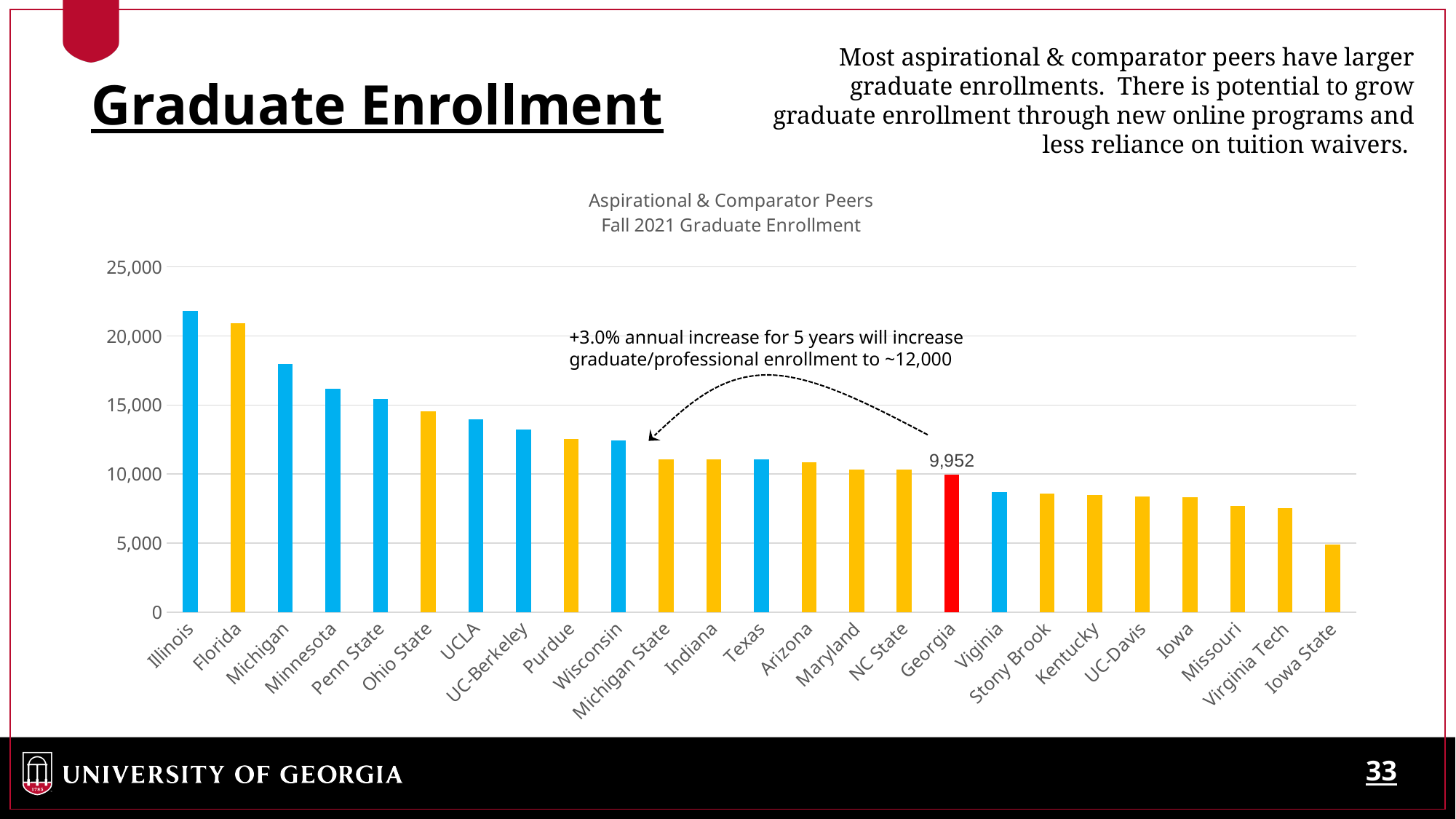
Is the value for Illinois greater or less than 20,000? greater Is the value for Viginia greater or less than 10,000? less How many institutions are shown in the chart? 25 Do the values rise or fall moving from left to right along the x axis? Fall What kind of chart is shown on the slide? Bar chart Which institution has the lowest graduate enrollment in the chart? Iowa State Which institution has the highest graduate enrollment in the chart? Illinois Which has the larger graduate enrollment, Georgia or Stony Brook? Georgia Is the value for Minnesota greater or less than 15,000? greater Which has the larger graduate enrollment, Florida or Michigan? Florida What is the Fall 2021 graduate enrollment shown for Georgia? 9,952